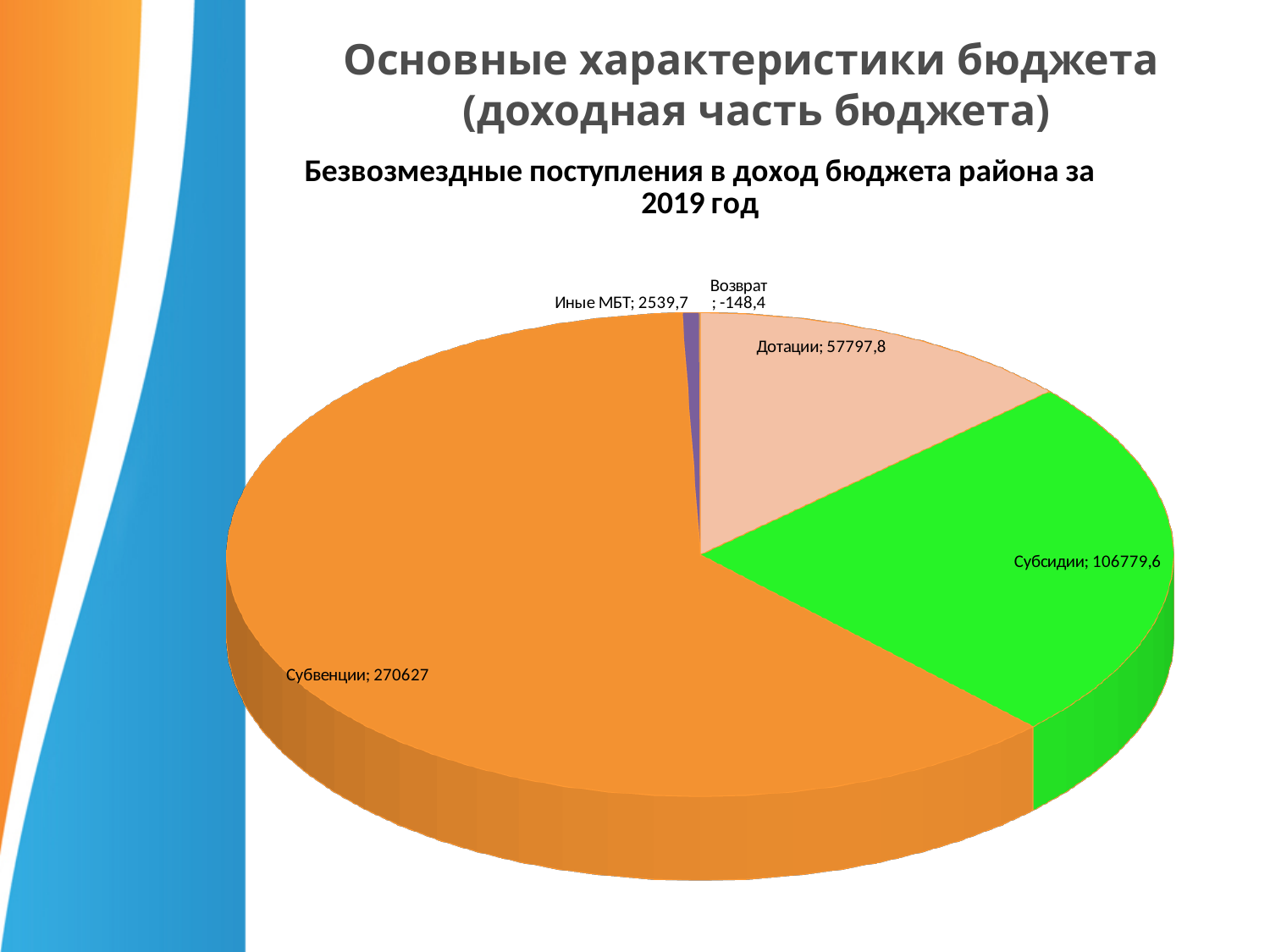
Which is larger, the value for Субсидии or the value for Дотации? Субсидии How many categories are shown in the pie chart? 5 What is the value for Субсидии? 106779,6 What is the title of the chart? Безвозмездные поступления в доход бюджета района за 2019 год What is the value for Иные МБТ? 2539,7 What is the difference between the values for Субвенции and Субсидии? 163847,4 What is the value for Субвенции? 270627 Which category has the largest value? Субвенции What kind of chart is shown on the slide? Pie chart Which category has the smallest value? Возврат What is the value for Дотации? 57797,8 What is the value for Возврат? -148,4